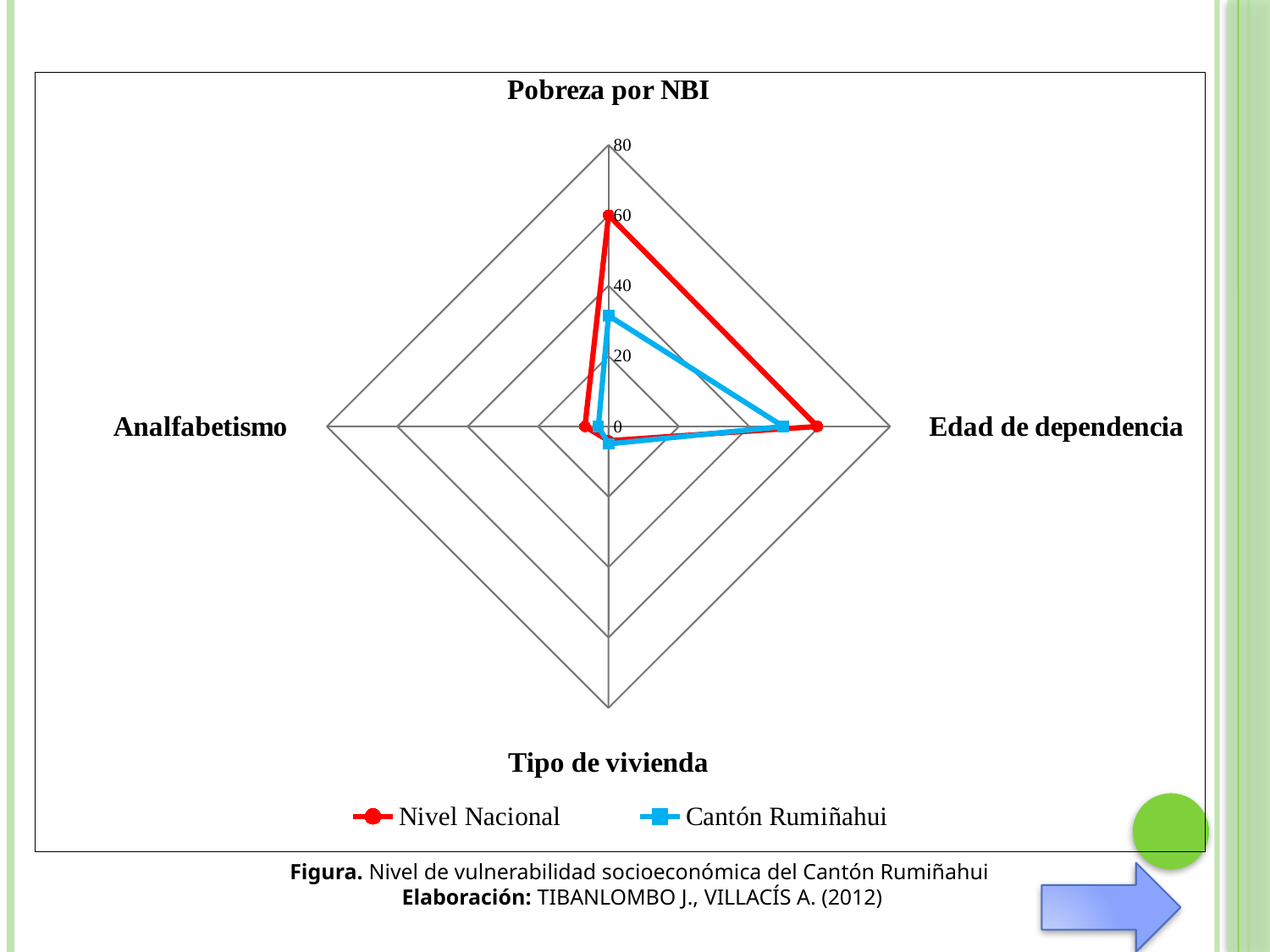
For Pobreza por NBI, which series has the larger value, Nivel Nacional or Cantón Rumiñahui? Nivel Nacional Is the Nivel Nacional value for Analfabetismo greater or less than 20? less How many indicator axes does the radar chart have? 4 On which indicator does Cantón Rumiñahui have its highest value? Edad de dependencia What is the Nivel Nacional value for Pobreza por NBI? 60 Which colour represents the Cantón Rumiñahui series? Blue How many series does the legend list? 2 For Edad de dependencia, which series has the larger value, Nivel Nacional or Cantón Rumiñahui? Nivel Nacional Is the Cantón Rumiñahui value for Pobreza por NBI greater or less than 40? less Is the Cantón Rumiñahui value for Edad de dependencia greater or less than 40? greater What kind of chart is shown on the slide? Radar chart On which indicator does Nivel Nacional have its lowest value? Tipo de vivienda